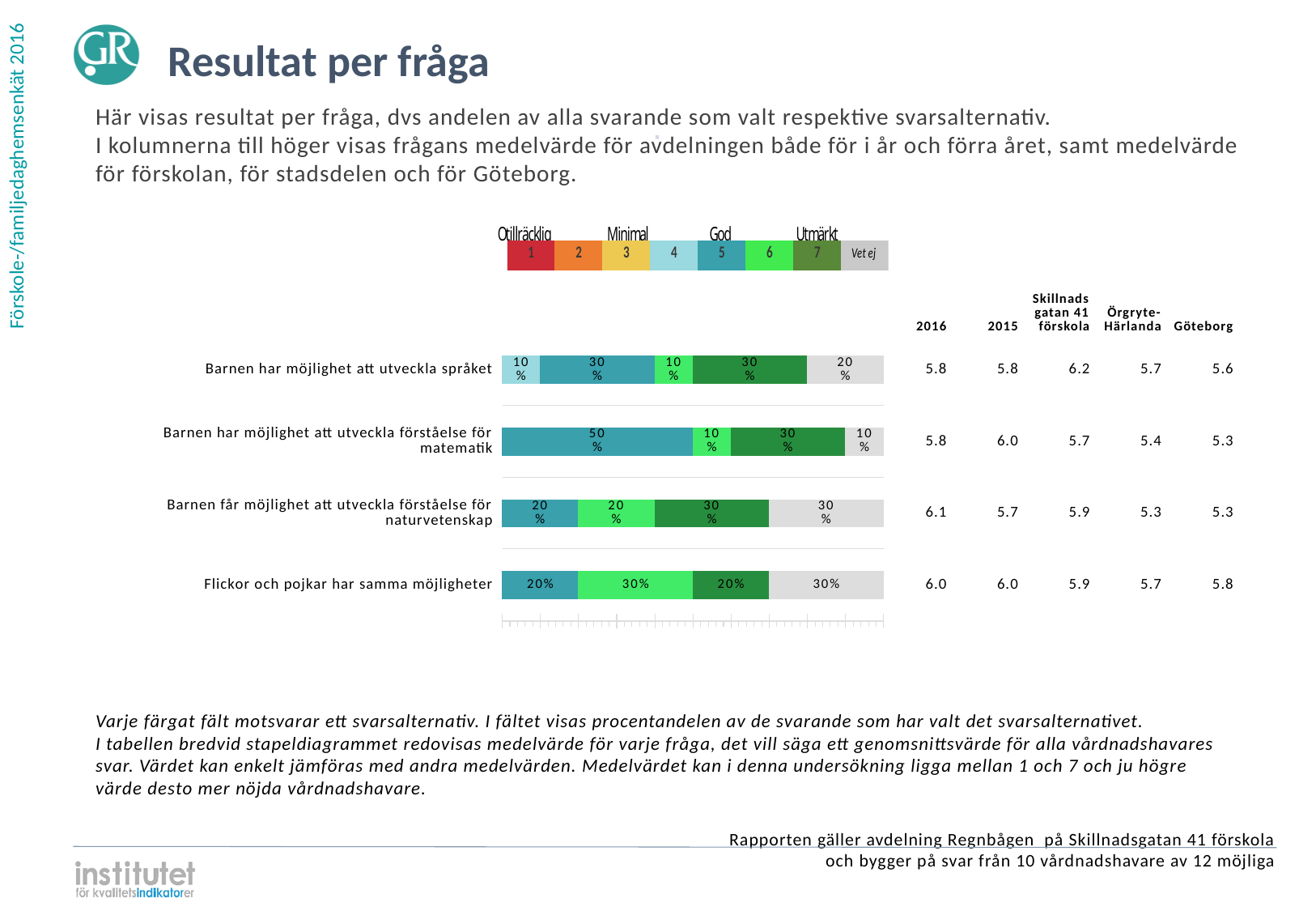
What kind of chart is used to show the results per question? Stacked bar chart What percentage is shown for the grey 'Vet ej' segment of 'Flickor och pojkar har samma möjligheter'? 30% Which question has the largest single segment in its bar? Barnen har möjlighet att utveckla förståelse för matematik What is the difference between the 'Vet ej' share for 'Barnen får möjlighet att utveckla förståelse för naturvetenskap' (30%) and for 'Barnen har möjlighet att utveckla språket' (20%)? 10 percentage points How many entries does the colour legend above the chart list? 8 What is the largest single segment value in the bar for 'Barnen har möjlighet att utveckla förståelse för matematik'? 50% What are the four scale labels written above the colour legend? Otillräcklig, Minimal, God, Utmärkt What do the segments of the bar for 'Flickor och pojkar har samma möjligheter' add up to? 100% Which has a larger 'Vet ej' share: 'Barnen har möjlighet att utveckla förståelse för matematik' or 'Flickor och pojkar har samma möjligheter'? Flickor och pojkar har samma möjligheter How many questions (categories) are plotted in the bar chart? 4 What percentage is shown for the light blue (4) segment of 'Barnen har möjlighet att utveckla språket'? 10% What is the 2016 mean value shown for 'Barnen får möjlighet att utveckla förståelse för naturvetenskap'? 6.1